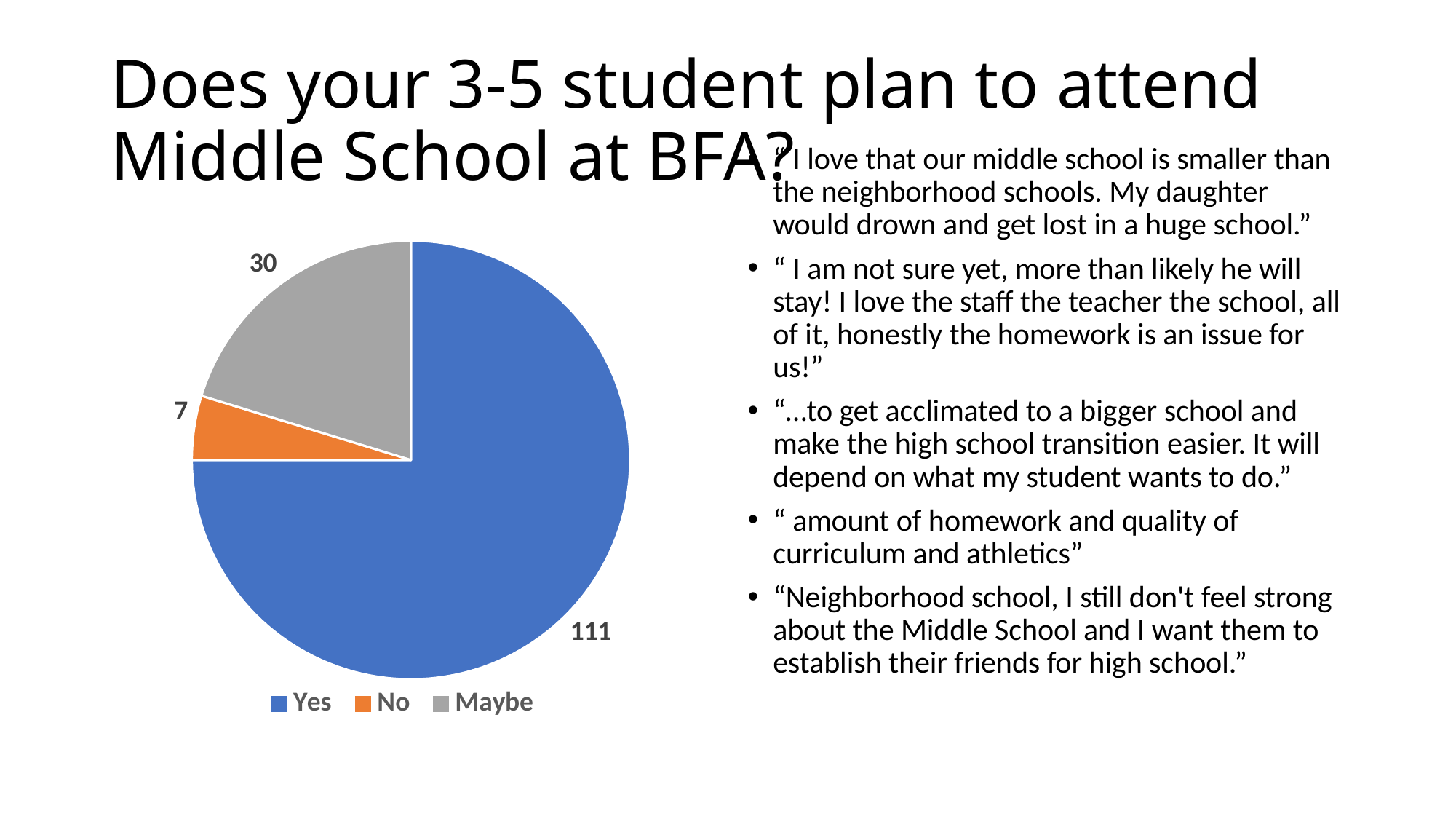
What is the difference between the Yes and Maybe counts? 81 What is the total of all responses shown in the pie chart? 148 How many responses are shown for Maybe? 30 How many responses are shown for Yes? 111 What kind of chart is shown on the slide? pie chart How many responses are shown for No? 7 Which response category has the smallest slice? No What is the difference between the Maybe and No counts? 23 Which response category has the largest slice? Yes How many categories does the pie chart have? 3 Which is larger, the Maybe count or the No count? Maybe Which colour represents the Maybe slice in the legend? gray